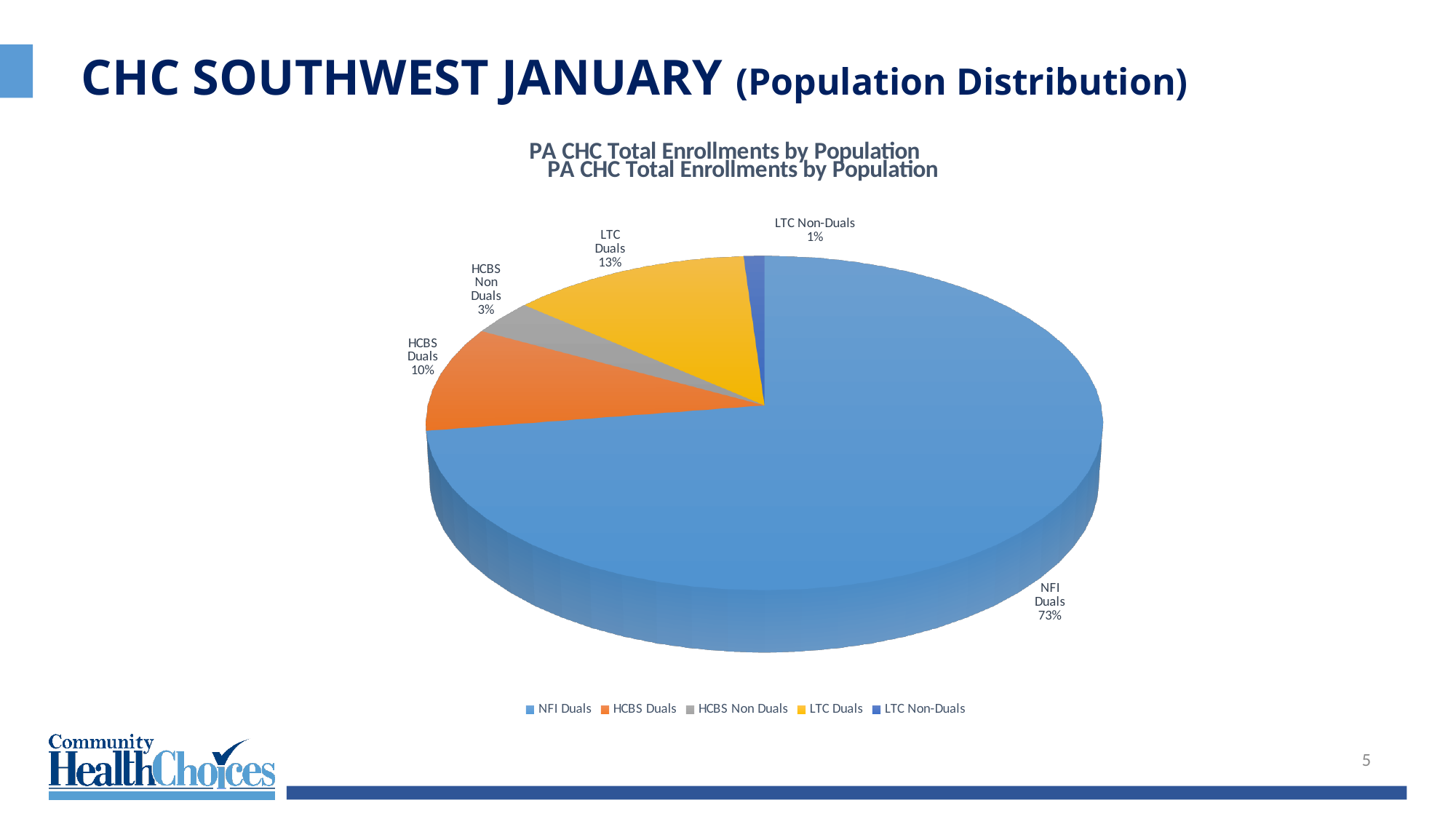
How many population categories are shown in the pie chart? 5 What is the title of the chart? PA CHC Total Enrollments by Population Which has a larger share, HCBS Duals or LTC Duals? LTC Duals Which population has the largest share of the pie? NFI Duals Which population has the smallest share of the pie? LTC Non-Duals What share of the pie does HCBS Non Duals represent? 3% What share of the pie does LTC Non-Duals represent? 1% What share of the pie does HCBS Duals represent? 10% What share of the pie does NFI Duals represent? 73% What is the difference in percentage points between the LTC Duals share and the HCBS Duals share? 3 What share of the pie does LTC Duals represent? 13% What kind of chart is shown on the slide? Pie chart